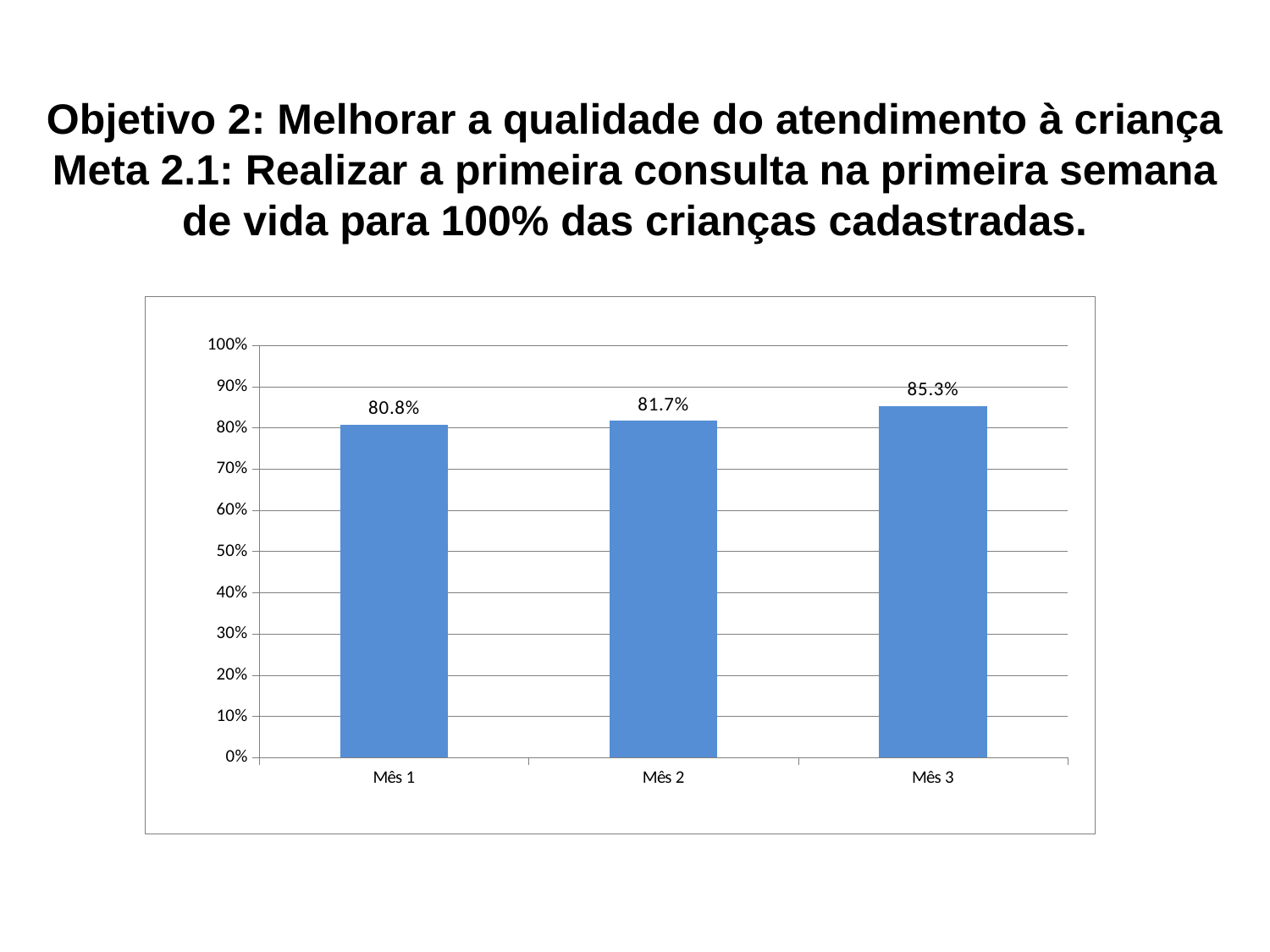
What is the difference between the values for Mês 2 and Mês 1? 0.9% Which month has the highest value? Mês 3 Which month has the lowest value? Mês 1 Is the value for Mês 3 greater or less than 90%? less What is the value for Mês 3? 85.3% Which is larger, the value for Mês 3 or the value for Mês 2? Mês 3 How many bars are shown in the chart? 3 Do the values rise or fall from Mês 1 to Mês 3? rise What is the difference between the values for Mês 3 and Mês 1? 4.5% What kind of chart is shown on the slide? bar chart What is the value for Mês 1? 80.8% What is the value for Mês 2? 81.7%